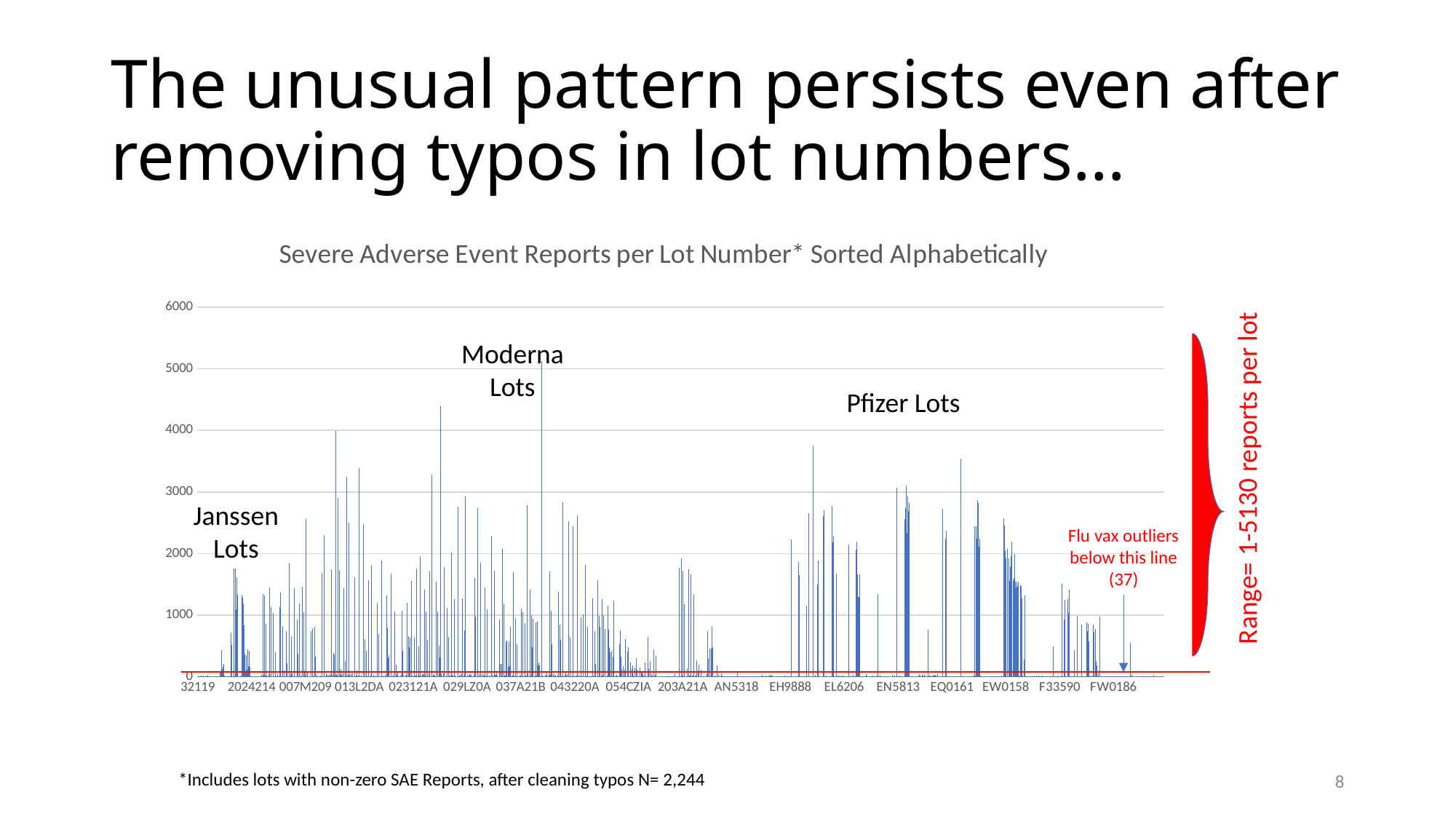
What is the maximum number of severe adverse event reports for a single lot, as stated in the range annotation? 5130 How many lots with non-zero SAE reports are included in the chart, according to the footnote? 2,244 How many vaccine manufacturer groups are labelled on the chart? 3 According to the annotation on the chart, what is the range of reports per lot? 1-5130 reports per lot Is the tallest bar in the Janssen Lots section greater or less than 3000 reports? less How many flu vax outliers are noted as falling below the red line on the chart? 37 What is the title of the chart? Severe Adverse Event Reports per Lot Number* Sorted Alphabetically What is the minimum number of severe adverse event reports for a single lot, as stated in the range annotation? 1 Which group of lots (Janssen, Moderna or Pfizer) contains the tallest bar on the chart? Moderna Lots What kind of chart is shown on the slide? bar chart Is the tallest bar on the chart greater or less than 5000 reports? greater What is the highest value shown on the chart's vertical axis? 6000